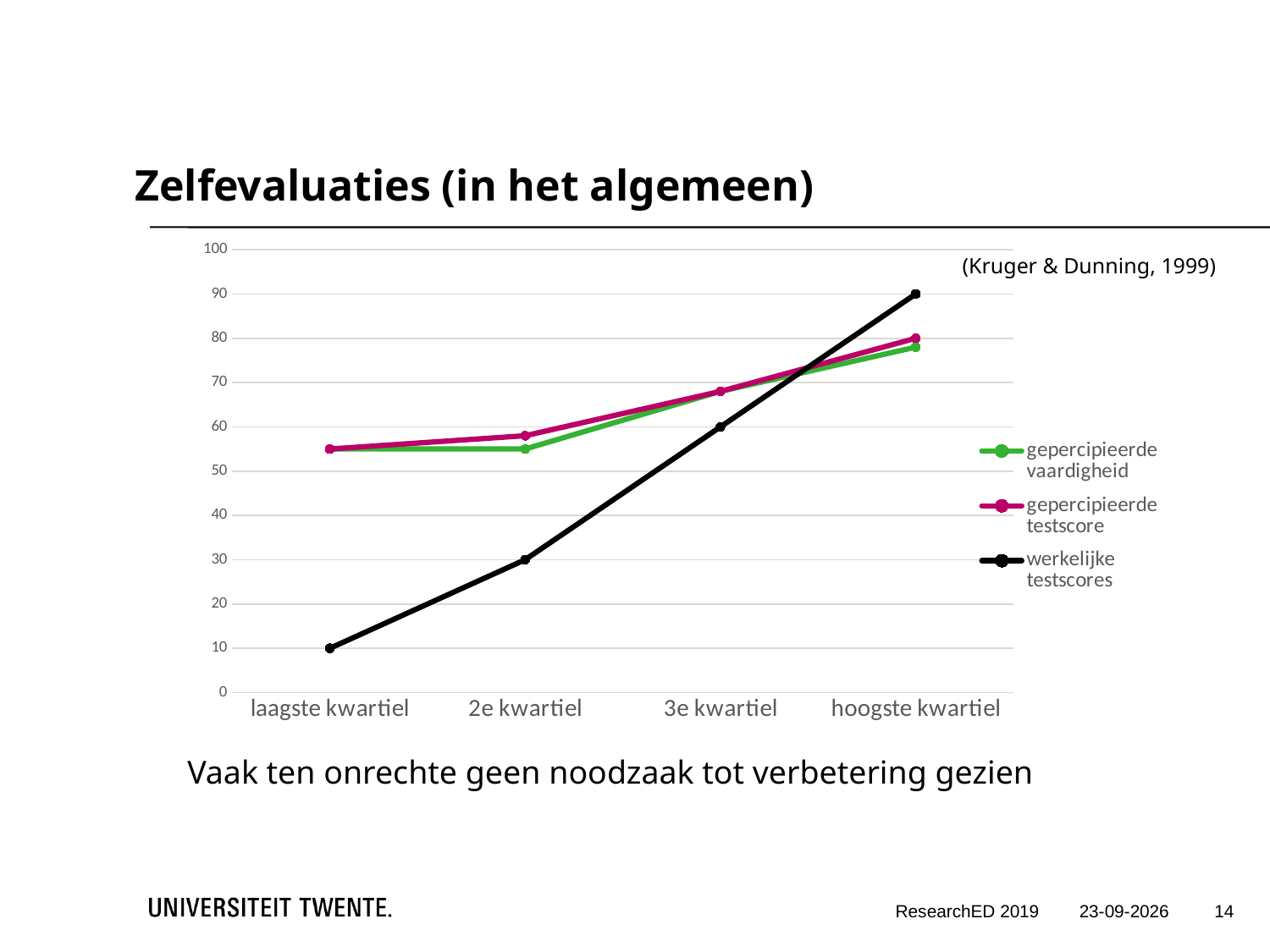
What is the value of werkelijke testscores for laagste kwartiel? 10 How many series does the legend list? 3 What is the value of werkelijke testscores for hoogste kwartiel? 90 What kind of chart is shown on the slide? line chart For laagste kwartiel, which is larger: gepercipieerde testscore or werkelijke testscores? gepercipieerde testscore What is the value of werkelijke testscores for 2e kwartiel? 30 Is the value of gepercipieerde vaardigheid for laagste kwartiel greater or less than 50? greater Which category has the lowest value for werkelijke testscores? laagste kwartiel Which series is drawn in black? werkelijke testscores What is the value of werkelijke testscores for 3e kwartiel? 60 Do the werkelijke testscores rise or fall from laagste kwartiel to hoogste kwartiel? rise How many categories are shown on the x axis? 4